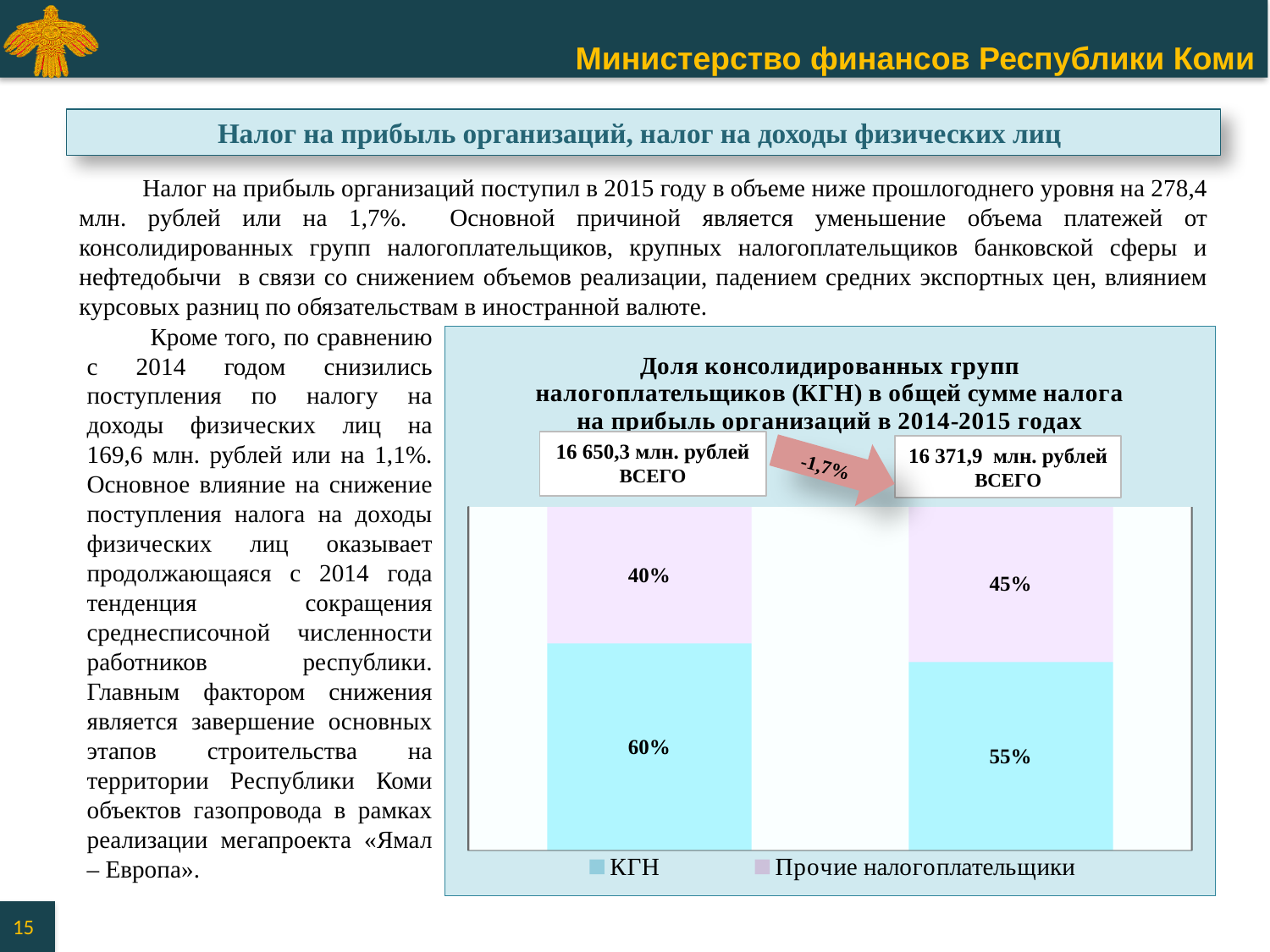
How many series does the chart legend list? 2 By how many percentage points does the КГН share in the left bar exceed the КГН share in the right bar? 5% How many stacked bars are plotted in the chart? 2 Does the КГН share rise or fall from the left bar to the right bar? fall What kind of chart is shown on the slide? bar chart What is the total of the two segments in the left bar? 100% In the right bar (total 16 371,9 млн. рублей), what is the share for КГН? 55% In the right bar, which is larger: the КГН share or the Прочие налогоплательщики share? КГН What percentage change is shown on the arrow between the two total labels above the bars? -1,7% In the left bar (total 16 650,3 млн. рублей), what is the share for КГН? 60% In the right bar (total 16 371,9 млн. рублей), what is the share for Прочие налогоплательщики? 45% In the left bar (total 16 650,3 млн. рублей), what is the share for Прочие налогоплательщики? 40%